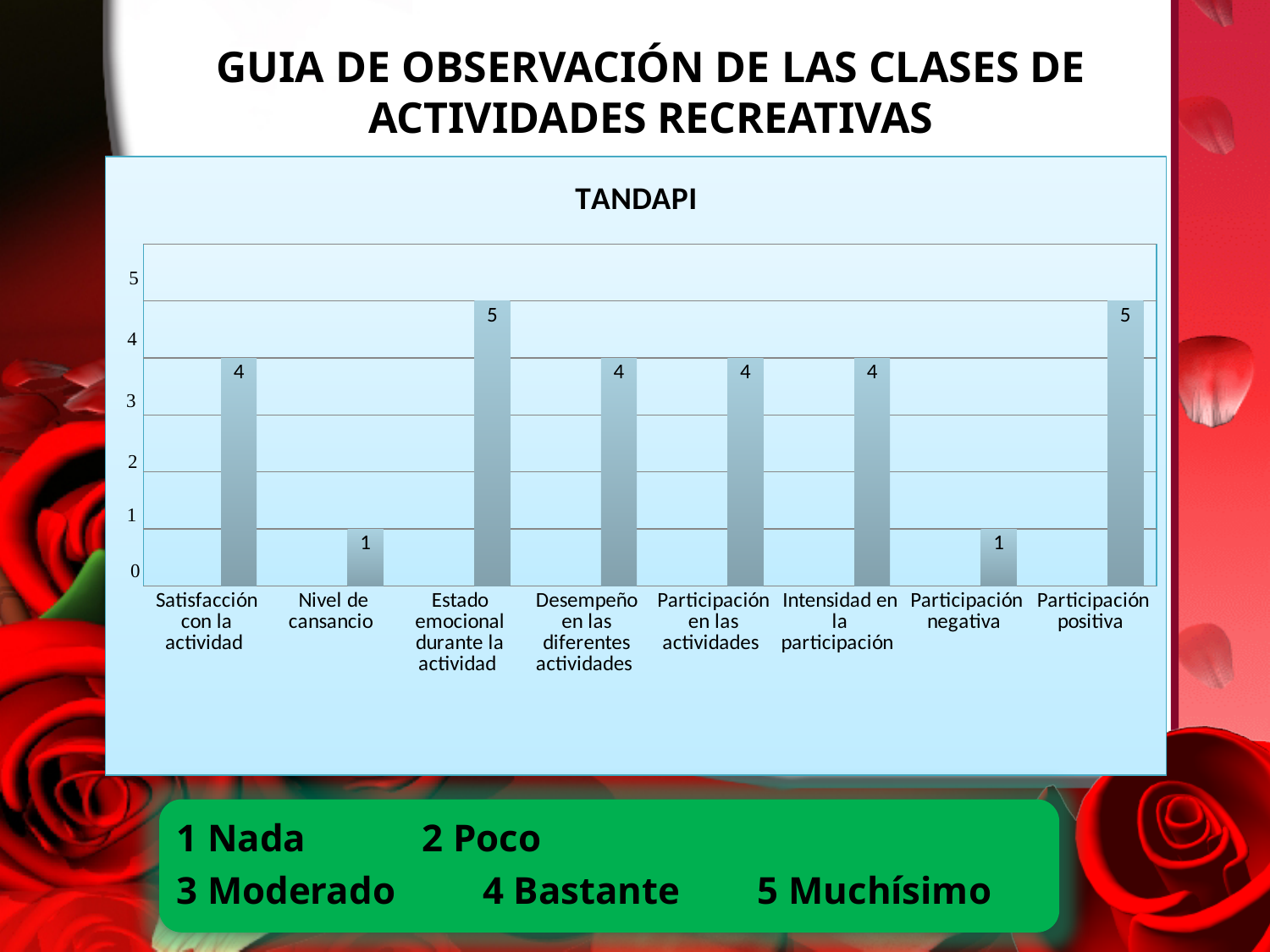
What is the value for Nivel de cansancio? 1 What is the difference between the values for Participación positiva and Participación negativa? 4 How many categories are shown in the chart? 8 What is the title of the chart? TANDAPI What is the value for Intensidad en la participación? 4 How many categories have a value of 4? 4 What is the value for Estado emocional durante la actividad? 5 What is the value for Participación negativa? 1 Which categories have the lowest value? Nivel de cansancio and Participación negativa Which is larger, the value for Satisfacción con la actividad or the value for Nivel de cansancio? Satisfacción con la actividad What kind of chart is shown on the slide? Bar chart Which categories have the highest value? Estado emocional durante la actividad and Participación positiva